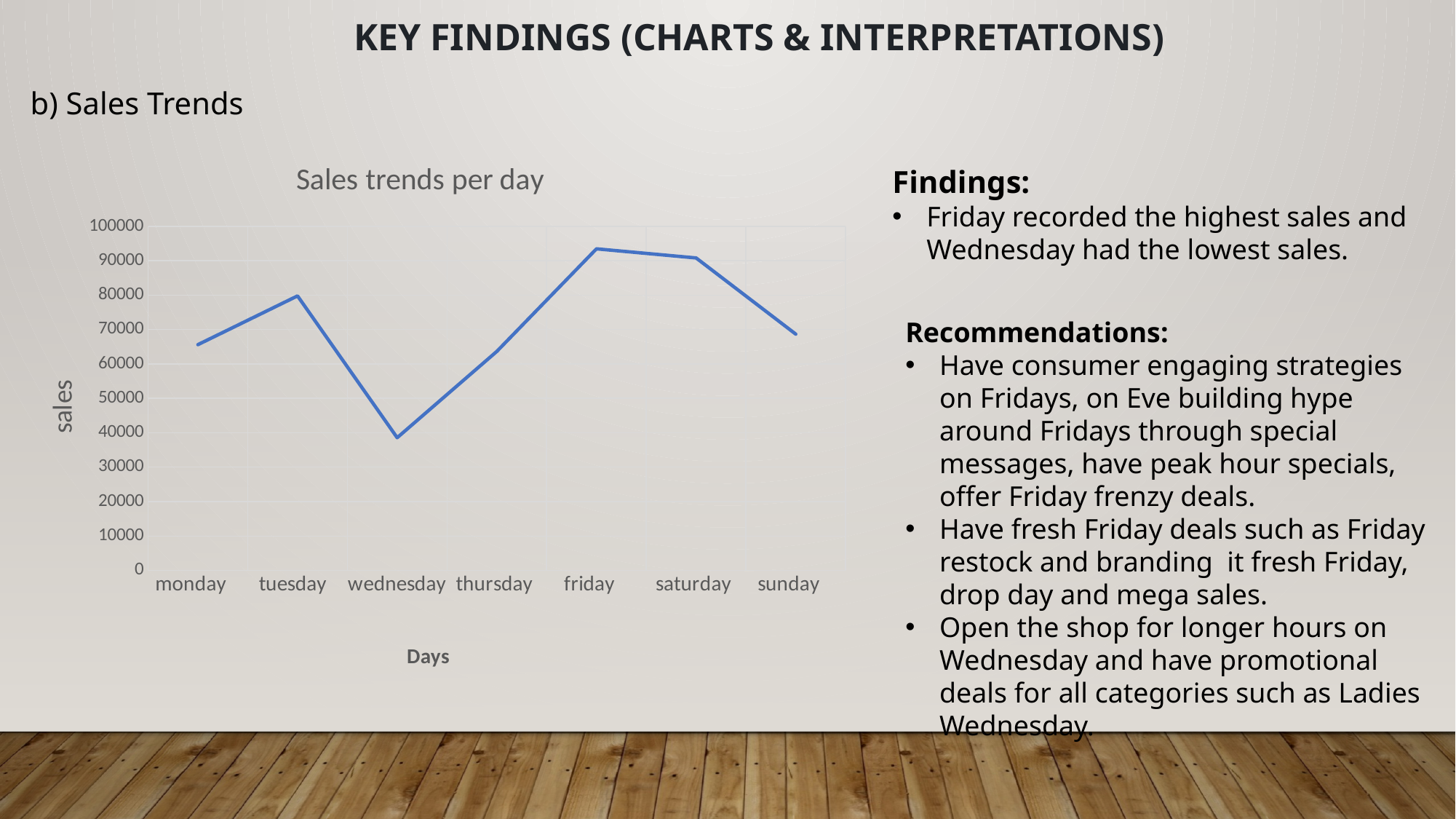
Is the value for saturday greater or less than 80000? greater Do sales rise or fall from wednesday to friday? rise Which day has the highest sales in the chart? friday Is the value for wednesday greater or less than 50000? less What is the title of the chart? Sales trends per day Which has higher sales, tuesday or thursday? tuesday What kind of chart is shown on the slide? line chart How many days are plotted on the x axis of the chart? 7 What is the label on the y axis of the chart? sales Is the value for monday greater or less than 60000? greater Which day has the lowest sales in the chart? wednesday